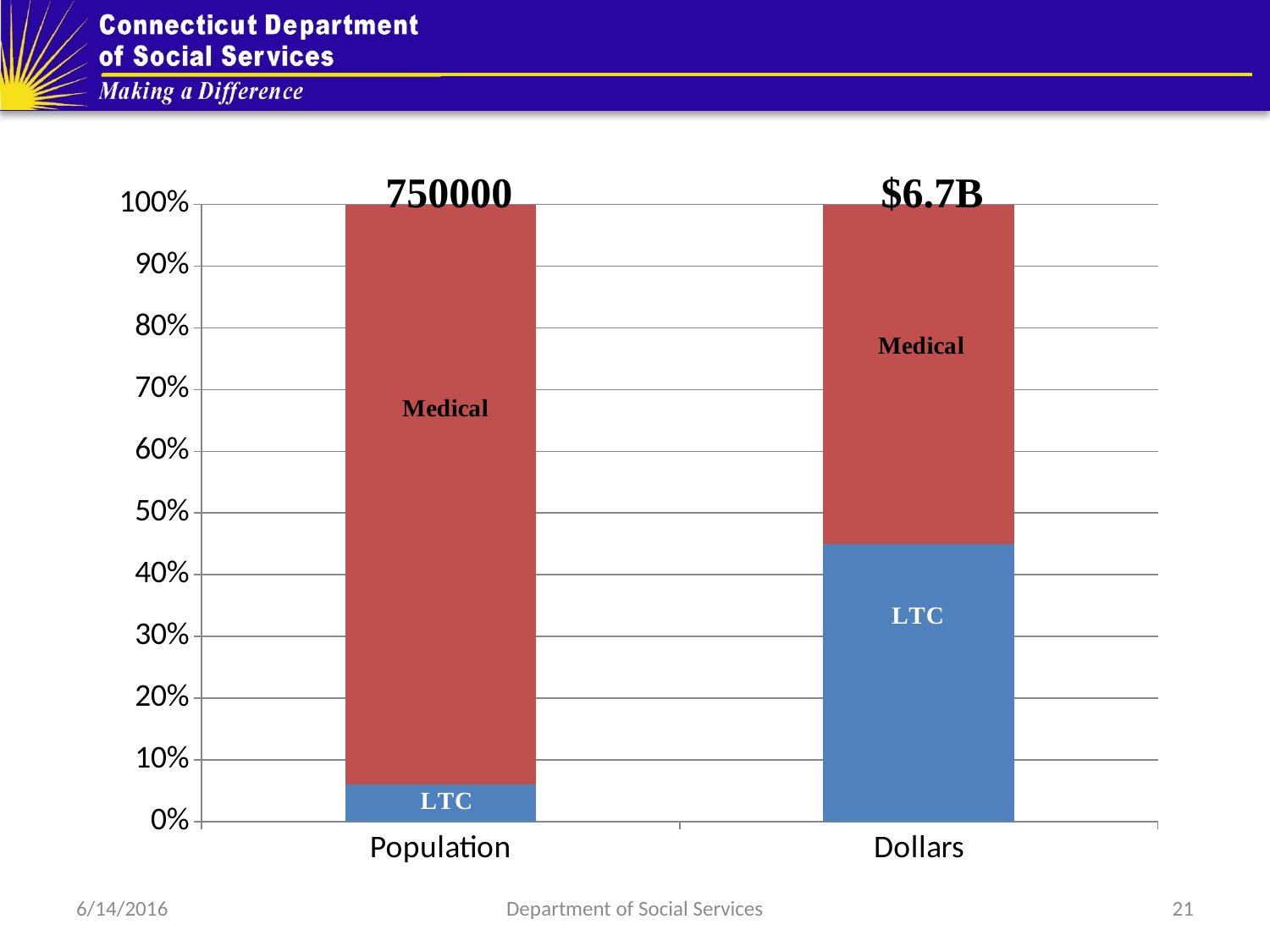
What kind of chart is shown on the slide? Stacked bar chart Is the LTC share of the Dollars bar greater or less than 40%? greater Is the Medical share of the Population bar greater or less than 90%? greater What label is printed above the Dollars bar? $6.7B Which category has the larger LTC share, Population or Dollars? Dollars What label is printed above the Population bar? 750000 Which category has the larger Medical share, Population or Dollars? Population Is the LTC share of the Dollars bar greater or less than 50%? less How many categories are shown on the x axis of the chart? 2 How many segments (series) make up each stacked bar in the chart? 2 What are the two categories on the x axis of the chart? Population and Dollars